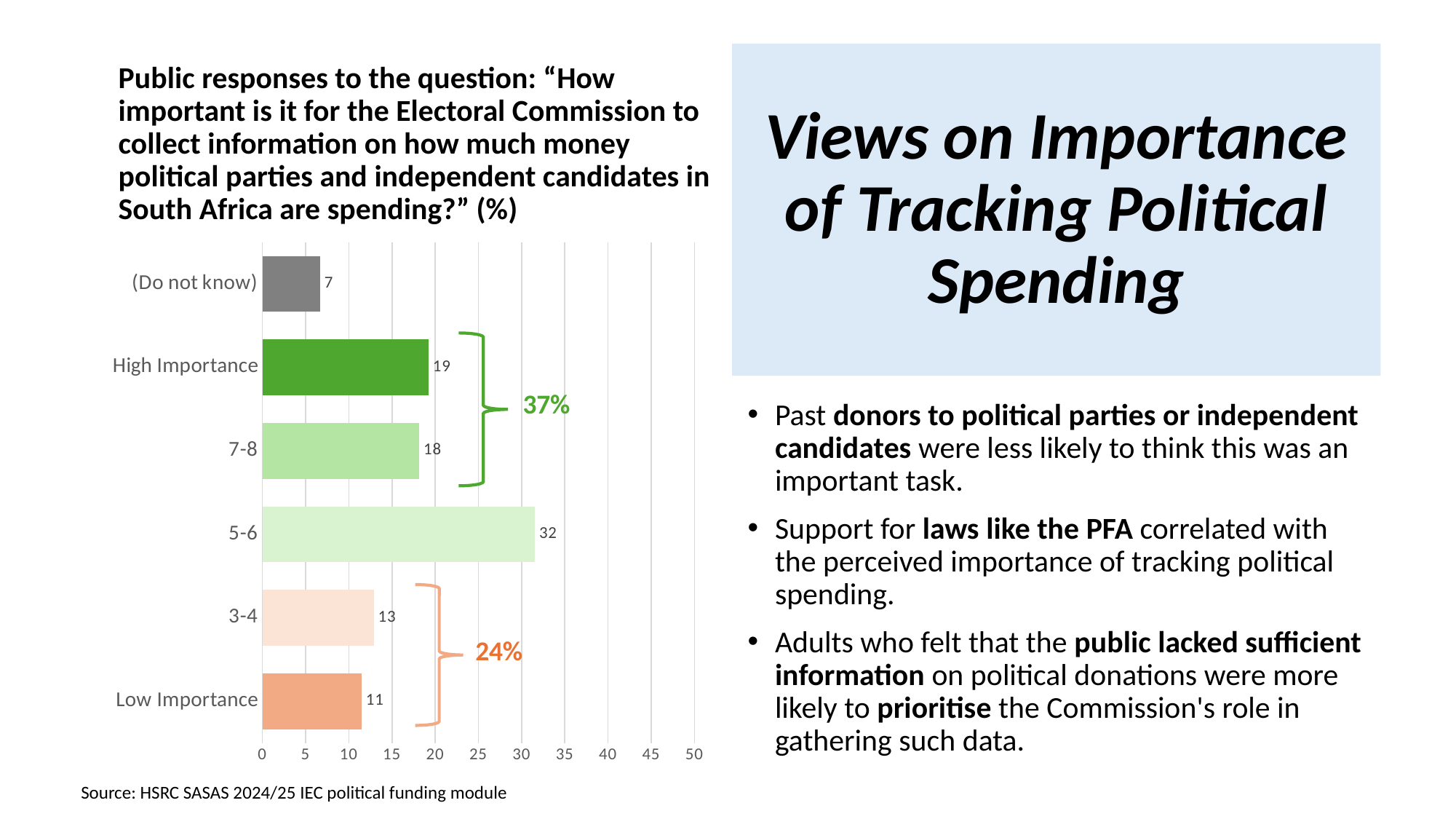
Which is larger, the value for 3-4 or the value for Low Importance? 3-4 Which category has the highest value? 5-6 Is the value for 5-6 greater or less than 30? greater Which category has the lowest value? (Do not know) What is the value for the (Do not know) category? 7 How many categories are shown in the chart? 6 What is the difference between the values for 5-6 and 3-4? 19 What combined percentage is shown by the green bracket grouping High Importance and 7-8? 37% What is the value for High Importance? 19 What is the value for Low Importance? 11 What kind of chart is shown on the slide? Bar chart What is the value for the 5-6 category? 32